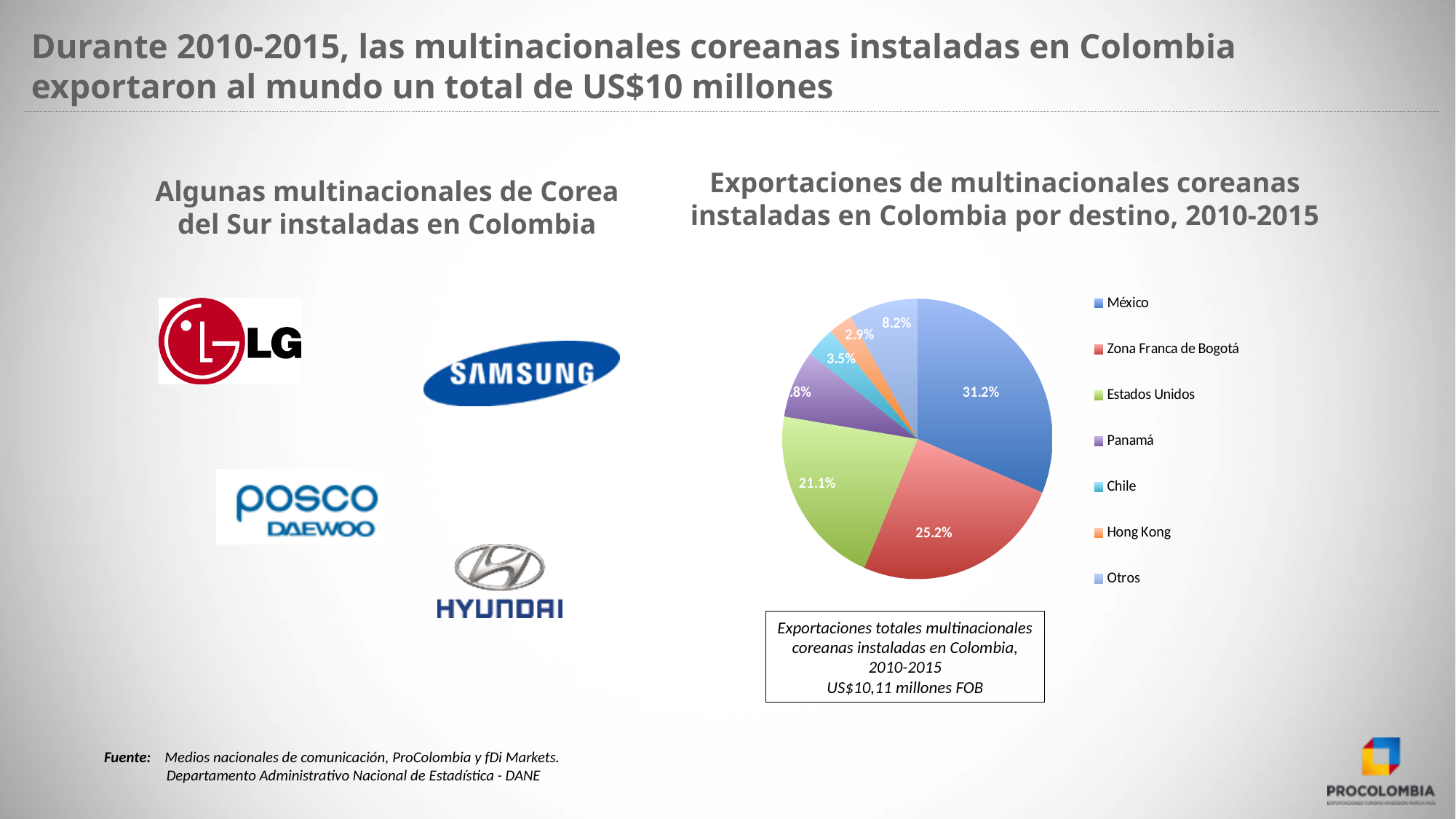
Which has a larger share, Zona Franca de Bogotá or Estados Unidos? Zona Franca de Bogotá What share of exports went to Zona Franca de Bogotá? 25.2% Which destination has the smallest share of exports? Hong Kong What is the difference in percentage points between the shares for México and Estados Unidos? 10.1 What share of exports is labelled Otros? 8.2% Which destination has the largest share of exports? México What share of exports went to Chile? 3.5% What kind of chart is shown on the slide? pie chart What share of exports went to Hong Kong? 2.9% What share of exports went to Estados Unidos? 21.1% What share of exports went to México? 31.2% How many destinations does the legend list? 7